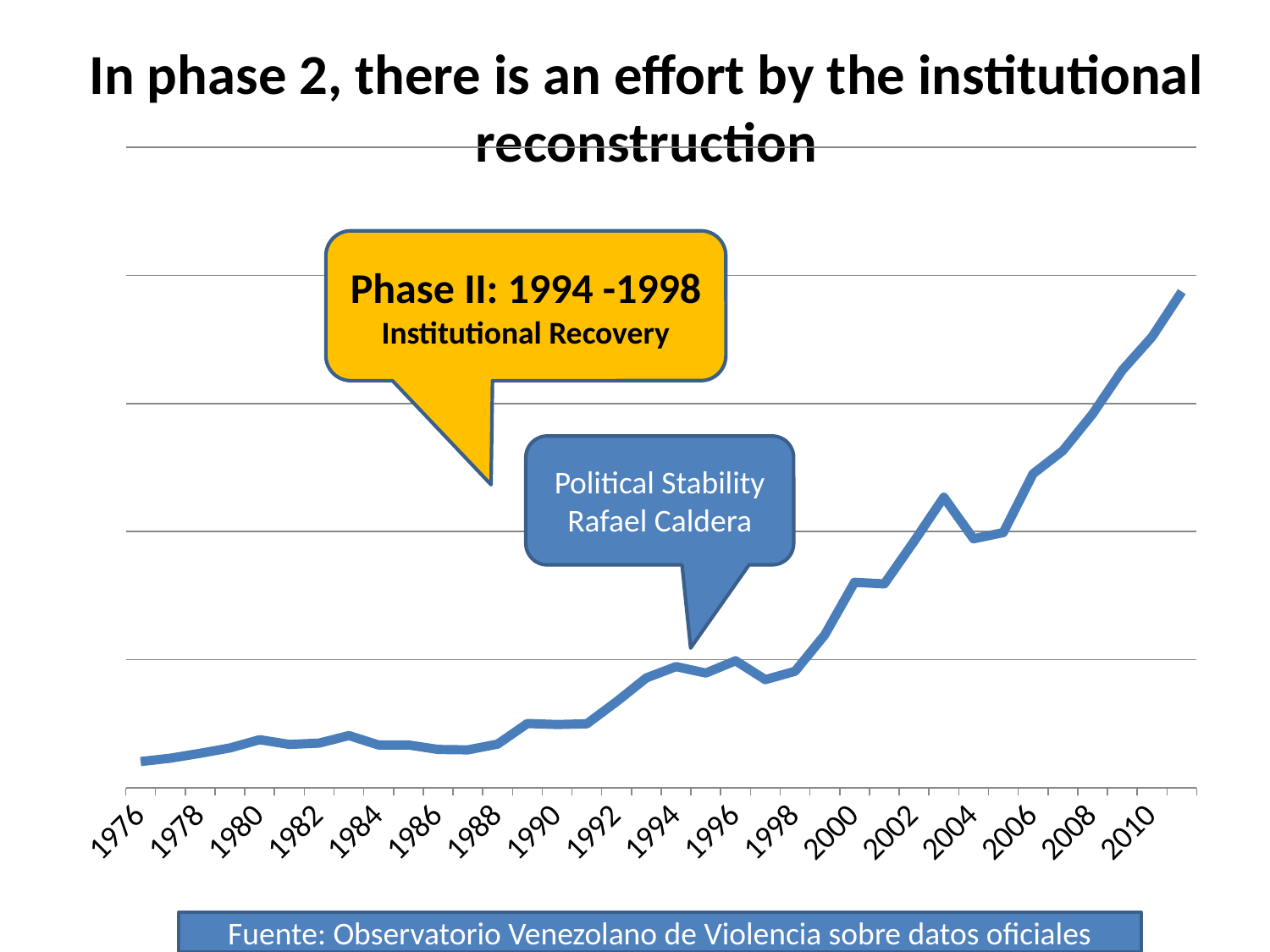
Which year has the larger value, 2003 or 2004? 2003 Overall, do the values rise or fall from 1976 to the end of the series? rise Which year has the lowest value on the line? 1976 Between 1994 and 1998, does the line rise steeply, or stay roughly flat? stay roughly flat What is the first year label shown on the x axis? 1976 How many year labels are printed on the x axis? 18 Which year has the larger value, 1990 or 1994? 1994 Which year has the highest value on the line? 2011 What kind of chart is shown on the slide? line chart Which year has the larger value, 2000 or 2006? 2006 What period does the yellow callout identify as Phase II? 1994 -1998